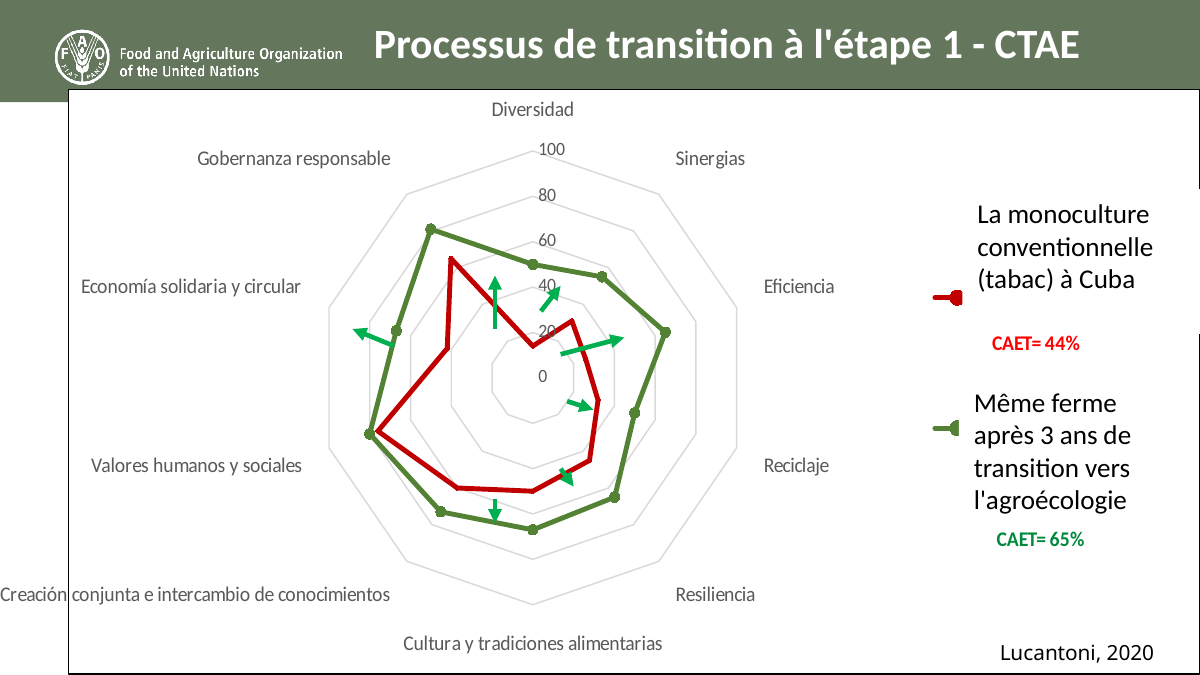
What CAET value is given for the same farm after 3 years of transition to agroecology (green series)? 65% Which category has the lowest value for the red (conventional monoculture) series? Diversidad Is the red series value for Diversidad greater or less than 20? less Is the green series value for Gobernanza responsable greater or less than 60? greater What kind of chart is shown on the slide? Radar chart Is the red series value for Reciclaje greater or less than 40? less How many series are plotted on the radar chart? 2 How many categories (axes) does the radar chart have? 10 For Diversidad, which series has the larger value, the red (conventional monoculture) or the green (after transition)? Green (after transition) What is the maximum value shown on the radar chart's axis scale? 100 What CAET value is given for the conventional tobacco monoculture in Cuba (red series)? 44%